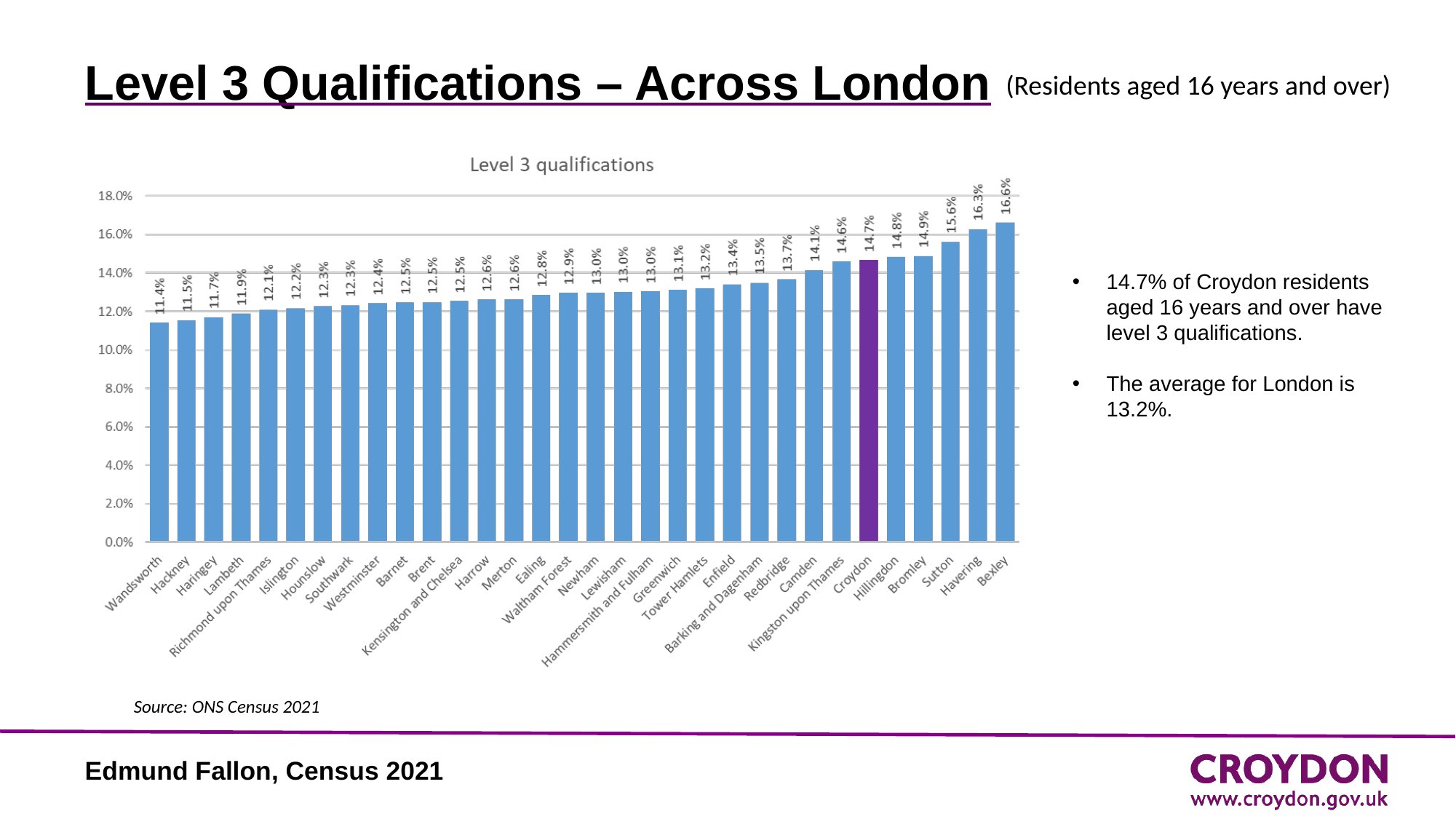
Which borough has the lowest value in the Level 3 qualifications chart? Wandsworth How many boroughs are shown in the Level 3 qualifications chart? 32 What kind of chart is used to show Level 3 qualifications across London? Bar chart Is the value for Havering in the Level 3 qualifications chart greater or less than 16.0%? greater Which borough has the highest value in the Level 3 qualifications chart? Bexley What is the value for Bexley in the Level 3 qualifications chart? 16.6% What is the value for Wandsworth in the Level 3 qualifications chart? 11.4% What is the value for Camden in the Level 3 qualifications chart? 14.1% Which has a higher value in the Level 3 qualifications chart, Sutton or Redbridge? Sutton What is the value for Croydon in the Level 3 qualifications chart? 14.7% Which bar in the Level 3 qualifications chart is coloured purple rather than blue? Croydon What is the difference between the values for Bexley and Croydon in the Level 3 qualifications chart? 1.9%